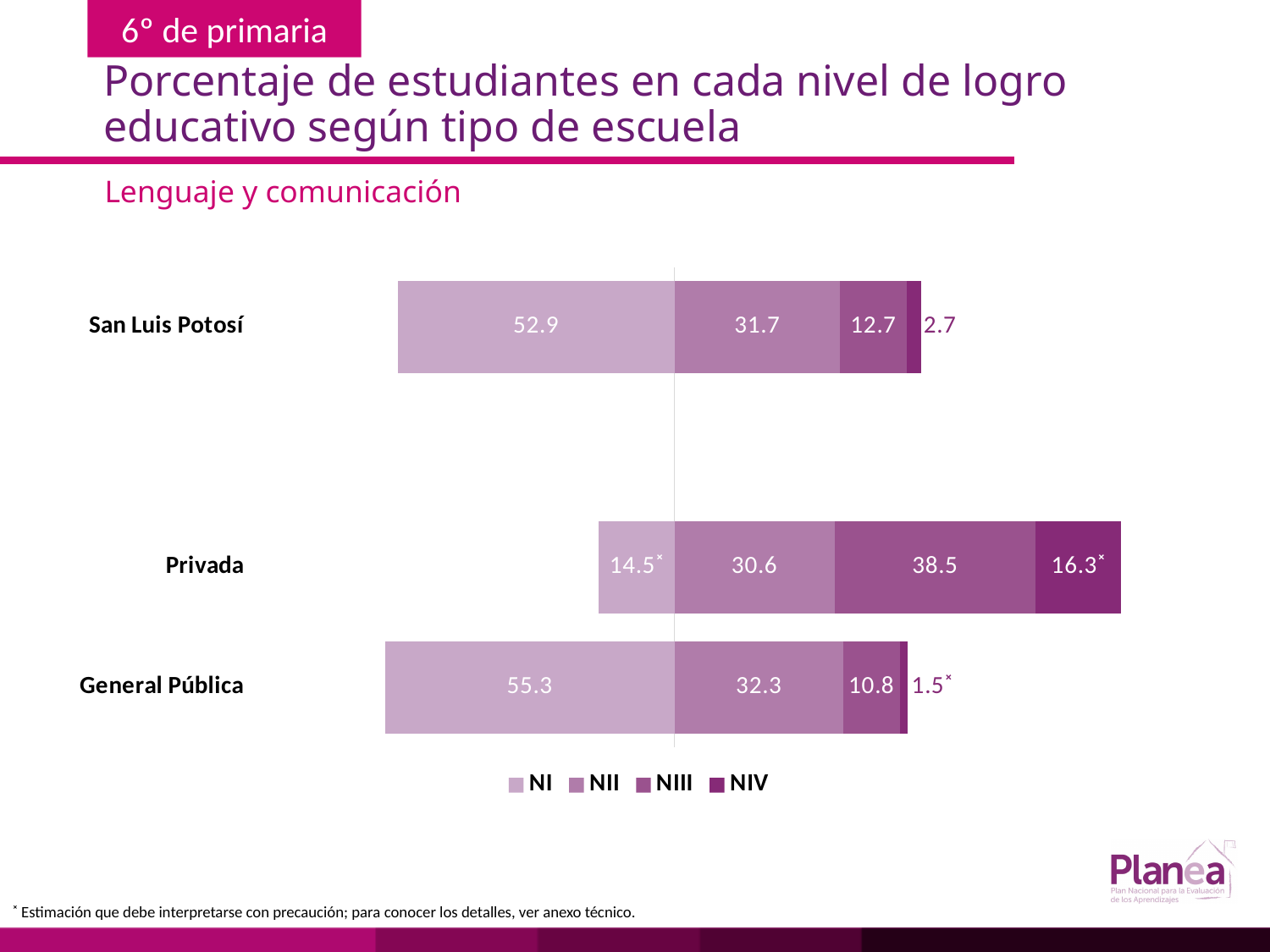
Which school type has the highest NI value? General Pública What is the NI value for San Luis Potosí? 52.9 What is the NIII value for Privada? 38.5 What kind of chart is shown on the slide? Stacked bar chart Which school type has the lowest NIV value? General Pública How many school types (categories) are shown in the chart? 3 What is the NIV value for General Pública? 1.5 Which is larger, the NII value for San Luis Potosí or the NII value for Privada? San Luis Potosí What is the total of the stacked bar for San Luis Potosí? 100.0 What is the difference between the NIII values for Privada and San Luis Potosí? 25.8 How many series does the legend list? 4 What is the NII value for General Pública? 32.3